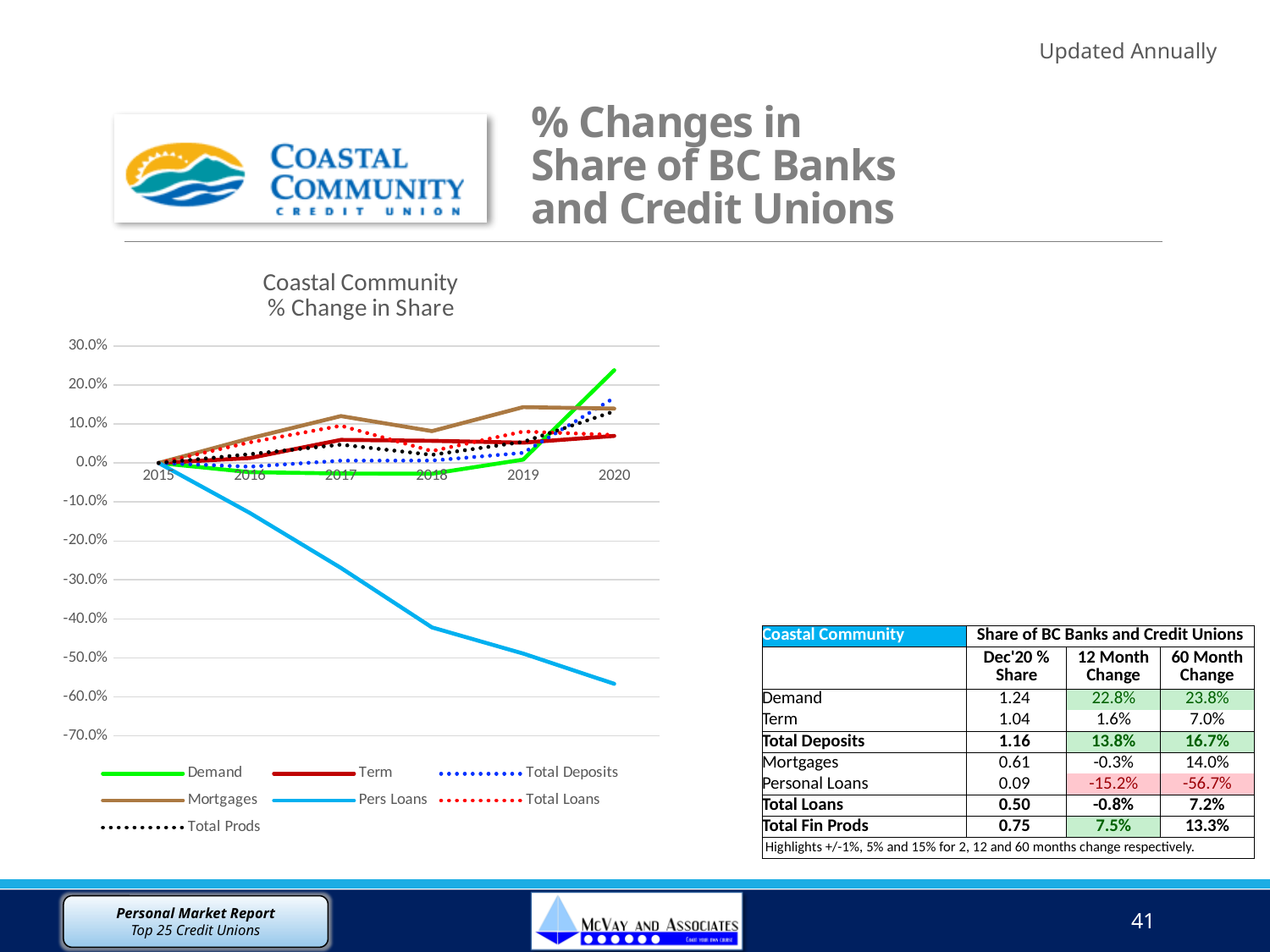
Which series has the lowest value in 2020? Pers Loans Which series is drawn as a solid green line? Demand Which series has the highest value in 2020? Demand What type of chart is shown on the slide? line chart What is the title of the chart? Coastal Community % Change in Share How many series does the legend of the chart list? 7 Is the value for Pers Loans in 2020 greater or less than -50.0%? less In 2020, which is larger: the value for Demand or the value for Mortgages? Demand Is the value for Pers Loans in 2019 greater or less than -40.0%? less Is the value for Demand in 2020 greater or less than 20.0%? greater How many years are shown along the x axis of the chart? 6 Does the Pers Loans line rise or fall from 2015 to 2020? fall